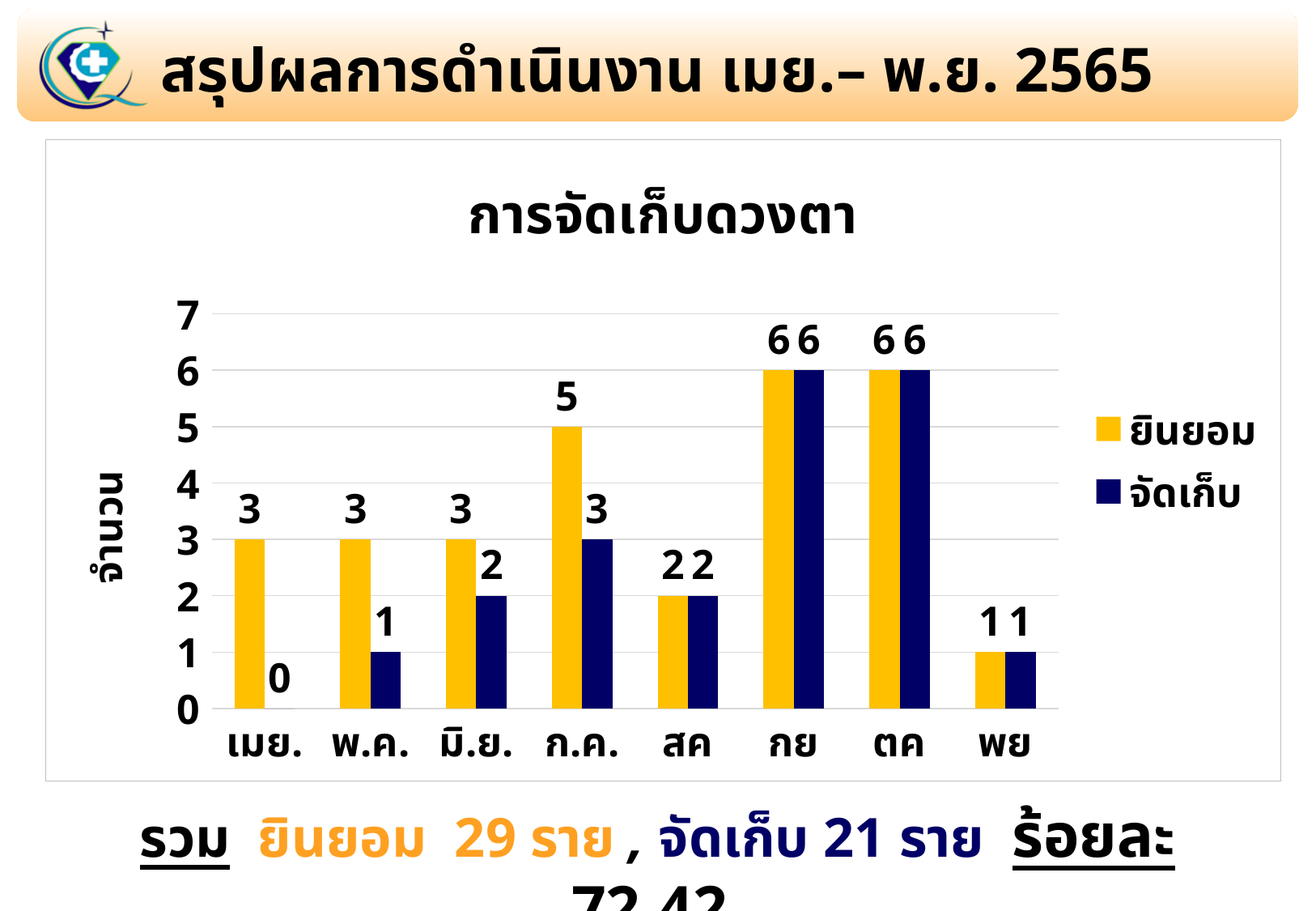
How many months (categories) are shown on the x axis? 8 Which month has the lowest ยินยอม value? พย Which is larger, the ยินยอม value for ก.ค. or the ยินยอม value for สค? ก.ค. Do the จัดเก็บ values rise or fall from เมย. to ก.ค.? rise What is the chart's title? การจัดเก็บดวงตา What type of chart is shown on the slide? bar chart What is the จัดเก็บ value for มิ.ย.? 2 Which series is shown in yellow? ยินยอม What is the difference between the ยินยอม and จัดเก็บ values for พ.ค.? 2 What is the ยินยอม value for ก.ค.? 5 How many series does the legend list? 2 What is the จัดเก็บ value for เมย.? 0